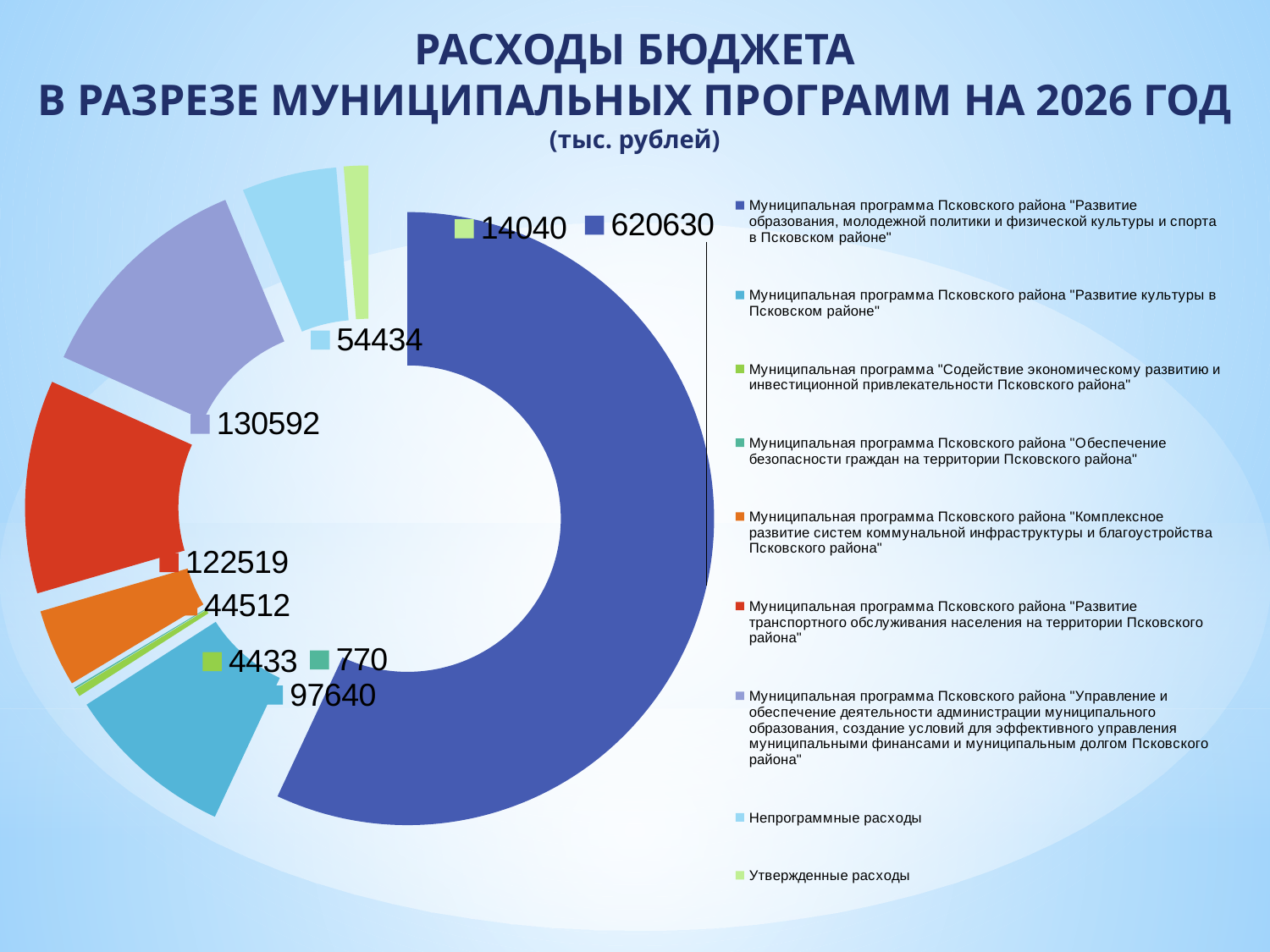
What is the value for "Непрограммные расходы"? 54434 What is the value for the municipal program "Развитие образования, молодежной политики и физической культуры и спорта в Псковском районе"? 620630 Which is larger: the value for the communal infrastructure program or the value for "Непрограммные расходы"? Непрограммные расходы What is the value for "Утвержденные расходы"? 14040 What is the difference between the value for the administration program (130592) and the transport program (122519)? 8073 What kind of chart is shown on the slide? Doughnut (pie) chart Which category has the largest value in the chart? Муниципальная программа Псковского района "Развитие образования, молодежной политики и физической культуры и спорта в Псковском районе" What is the value for the municipal program "Развитие транспортного обслуживания населения на территории Псковского района"? 122519 In what units are the values on the chart given, according to the title? тыс. рублей Which category has the smallest value in the chart? Муниципальная программа Псковского района "Обеспечение безопасности граждан на территории Псковского района" What is the value for the municipal program "Развитие культуры в Псковском районе"? 97640 How many categories does the legend list? 9